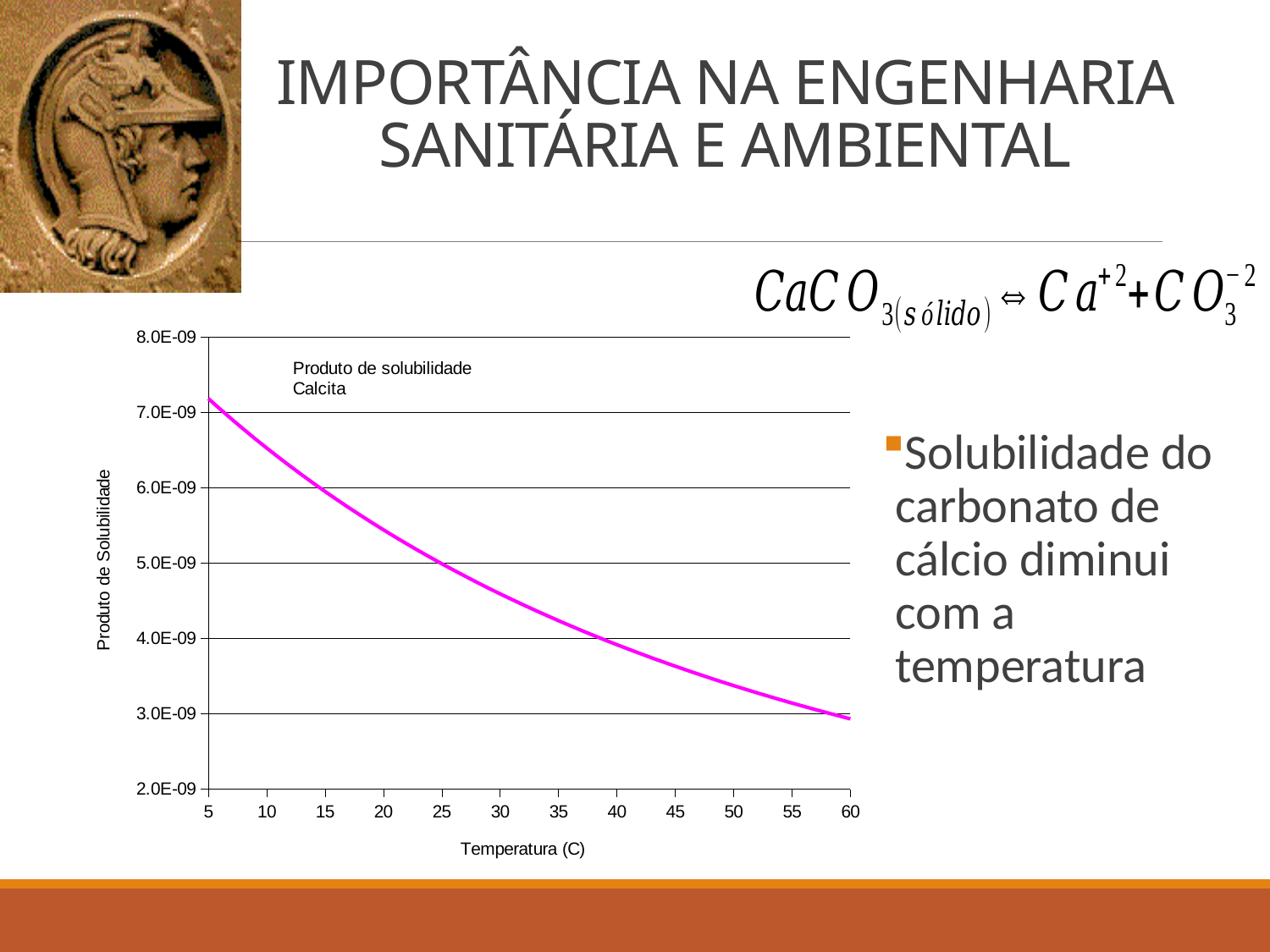
Does the solubility product of calcite rise or fall as temperature increases along the x axis? fall Is the solubility product at 10 °C greater or less than 6.0E-09? greater Is the solubility product at 35 °C greater or less than 4.0E-09? greater At which temperature on the x axis is the solubility product lowest? 60 At which temperature on the x axis is the solubility product highest? 5 What is the title of the x axis of the chart? Temperatura (C) Is the solubility product at 20 °C greater or less than 5.0E-09? greater Which is larger, the solubility product at 20 °C or at 45 °C? 20 °C What kind of chart is shown on the slide? line chart What is the title shown inside the chart area? Produto de solubilidade Calcita